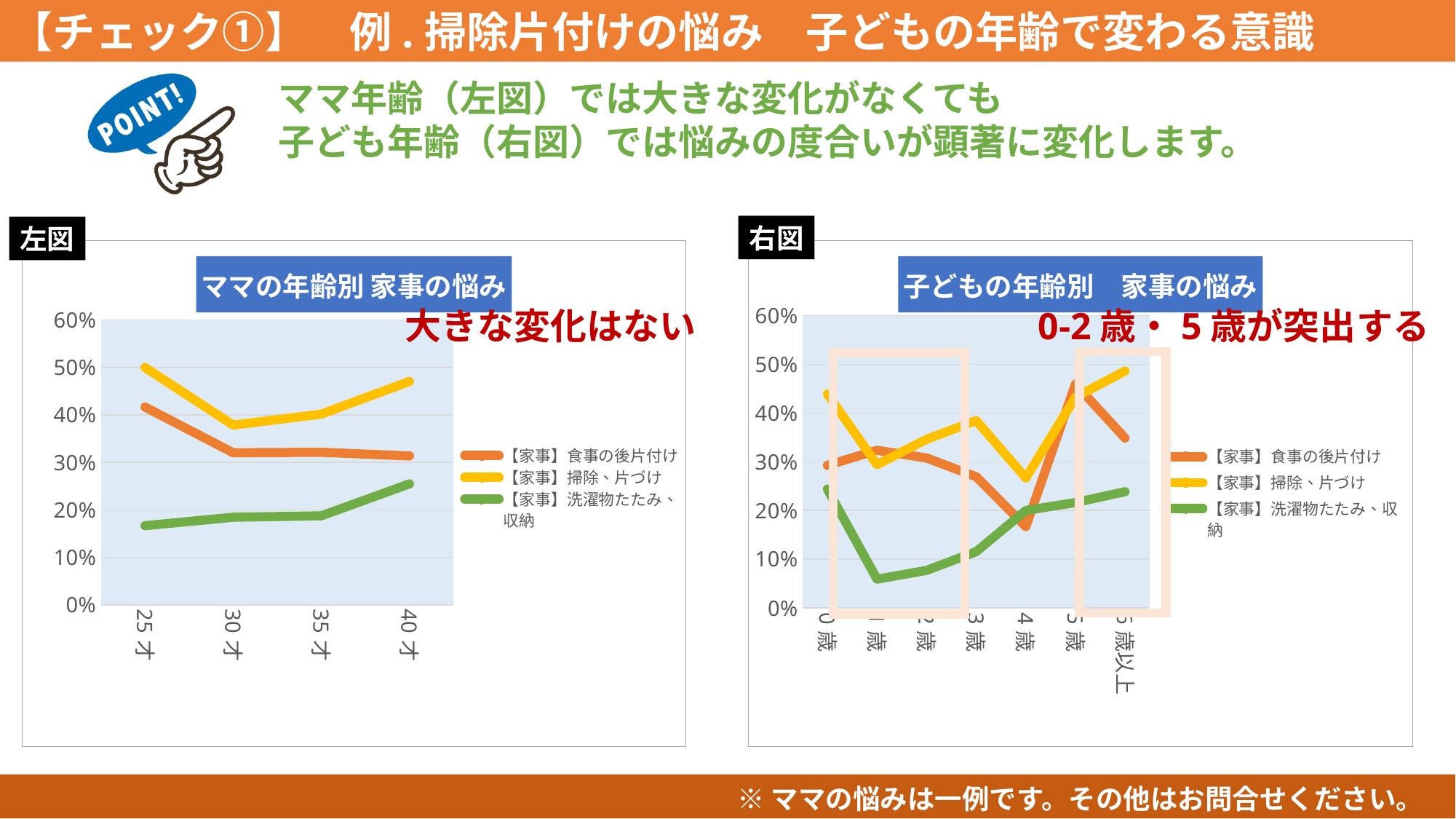
How many series does the legend of the right chart (子どもの年齢別 家事の悩み) list? 3 How many age categories are shown on the x axis of the left chart (ママの年齢別 家事の悩み)? 4 In the right chart (子どもの年齢別 家事の悩み), at which age is 【家事】洗濯物たたみ、収納 lowest? 1歳 What kind of chart is the left chart (ママの年齢別 家事の悩み)? line chart In the left chart (ママの年齢別 家事の悩み), does 【家事】洗濯物たたみ、収納 rise or fall from 25才 to 40才? rise How many age categories are shown on the x axis of the right chart (子どもの年齢別 家事の悩み)? 7 In the right chart (子どもの年齢別 家事の悩み), is the value for 【家事】洗濯物たたみ、収納 at 1歳 greater or less than 10%? less In the left chart (ママの年齢別 家事の悩み), at 30才, which is larger: 【家事】掃除、片づけ or 【家事】食事の後片付け? 【家事】掃除、片づけ What is the title of the right chart? 子どもの年齢別 家事の悩み In the right chart (子どもの年齢別 家事の悩み), is the value for 【家事】食事の後片付け at 4歳 greater or less than 20%? less In the left chart (ママの年齢別 家事の悩み), is the value for 【家事】掃除、片づけ at 30才 greater or less than 40%? less